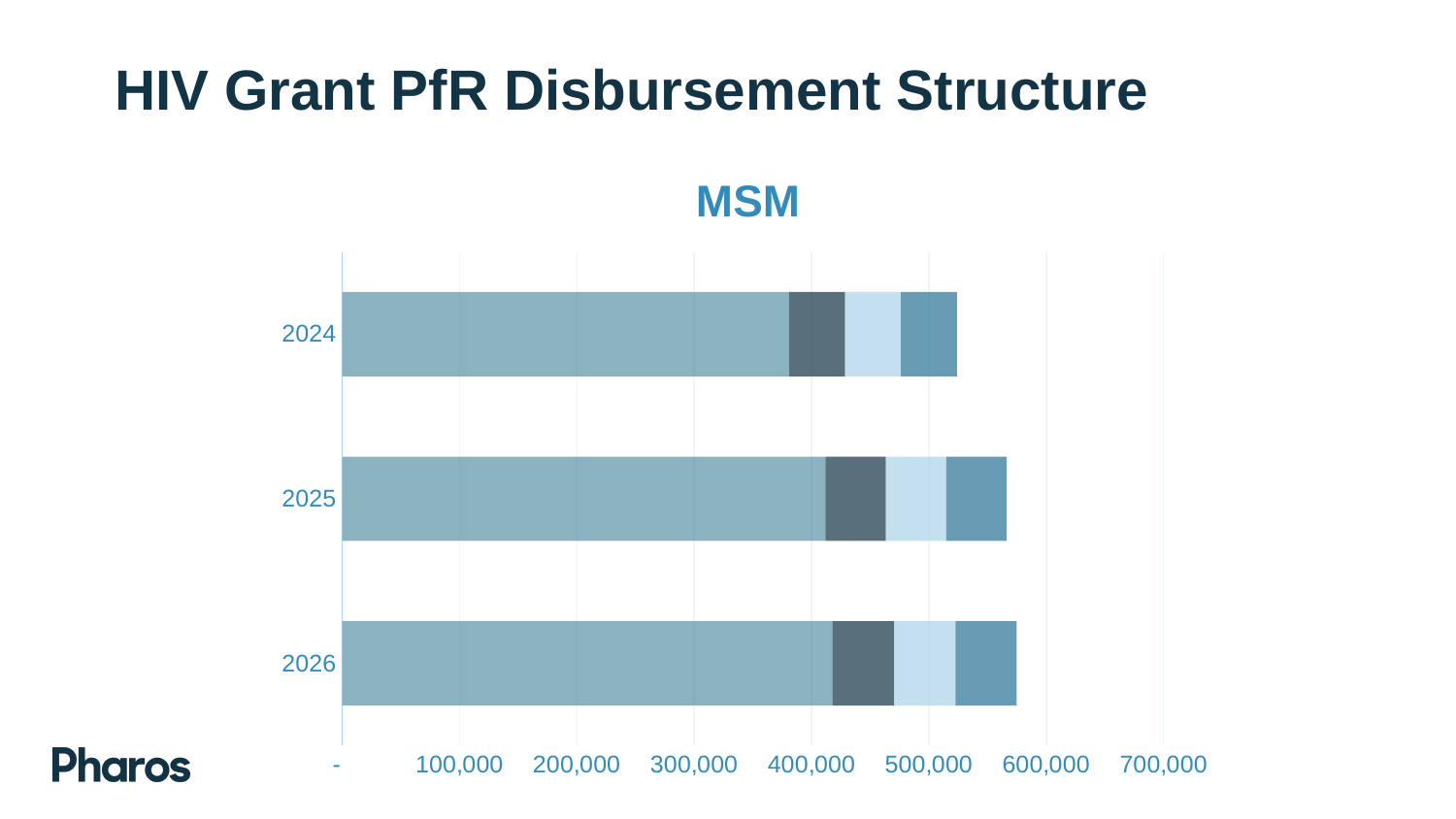
What is the highest value labelled on the horizontal axis? 700,000 Is the total bar for 2026 greater or less than 600,000? less Is the total bar for 2024 greater or less than 600,000? less Is the total bar for 2026 greater or less than 500,000? greater How many coloured segments make up each bar? 4 Is the total bar for 2025 larger or smaller than the total bar for 2024? larger What kind of chart is shown on the slide? Stacked bar chart Do the total bar lengths rise or fall from 2024 to 2026? rise What is the title of the chart? MSM Which year has the shortest total bar? 2024 How many categories (years) are shown on the chart? 3